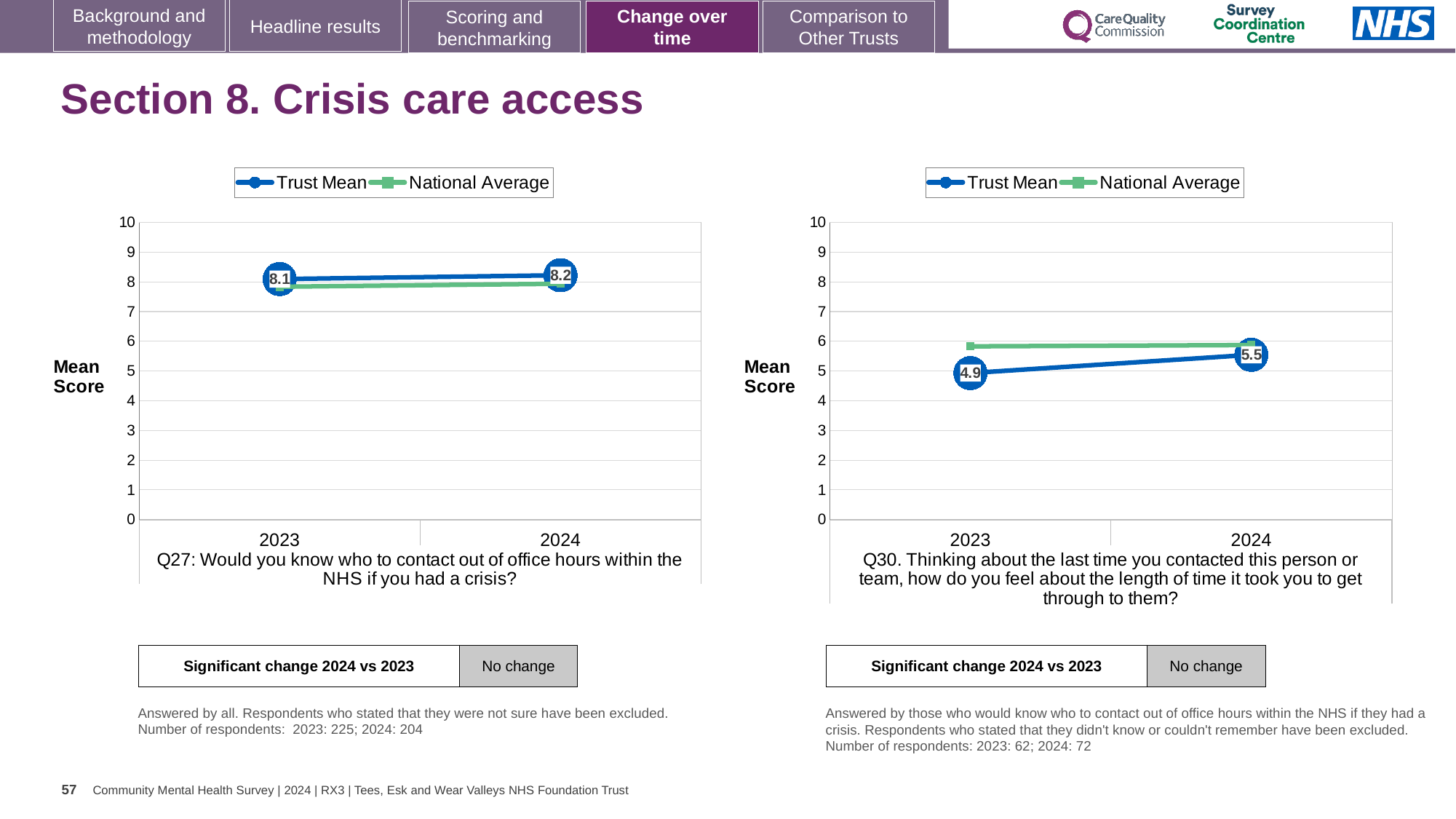
How many years are shown on the x axis of the left chart (Q27)? 2 How many series does the legend of the left chart (Q27) list? 2 In the left chart (Q27), what is the Trust Mean score for 2023? 8.1 In the right chart (Q30), what is the Trust Mean score for 2023? 4.9 In the left chart (Q27), which is higher in 2023: the Trust Mean or the National Average? Trust Mean In the right chart (Q30), is the National Average value for 2023 greater or less than 5? greater In the right chart (Q30), what is the Trust Mean score for 2024? 5.5 What kind of chart is the right chart (Q30)? line chart In the left chart (Q27), what is the difference between the Trust Mean in 2024 and in 2023? 0.1 In the right chart (Q30), does the Trust Mean rise or fall from 2023 to 2024? rise In the left chart (Q27), what is the Trust Mean score for 2024? 8.2 In the right chart (Q30), by how much did the Trust Mean change from 2023 to 2024? 0.6